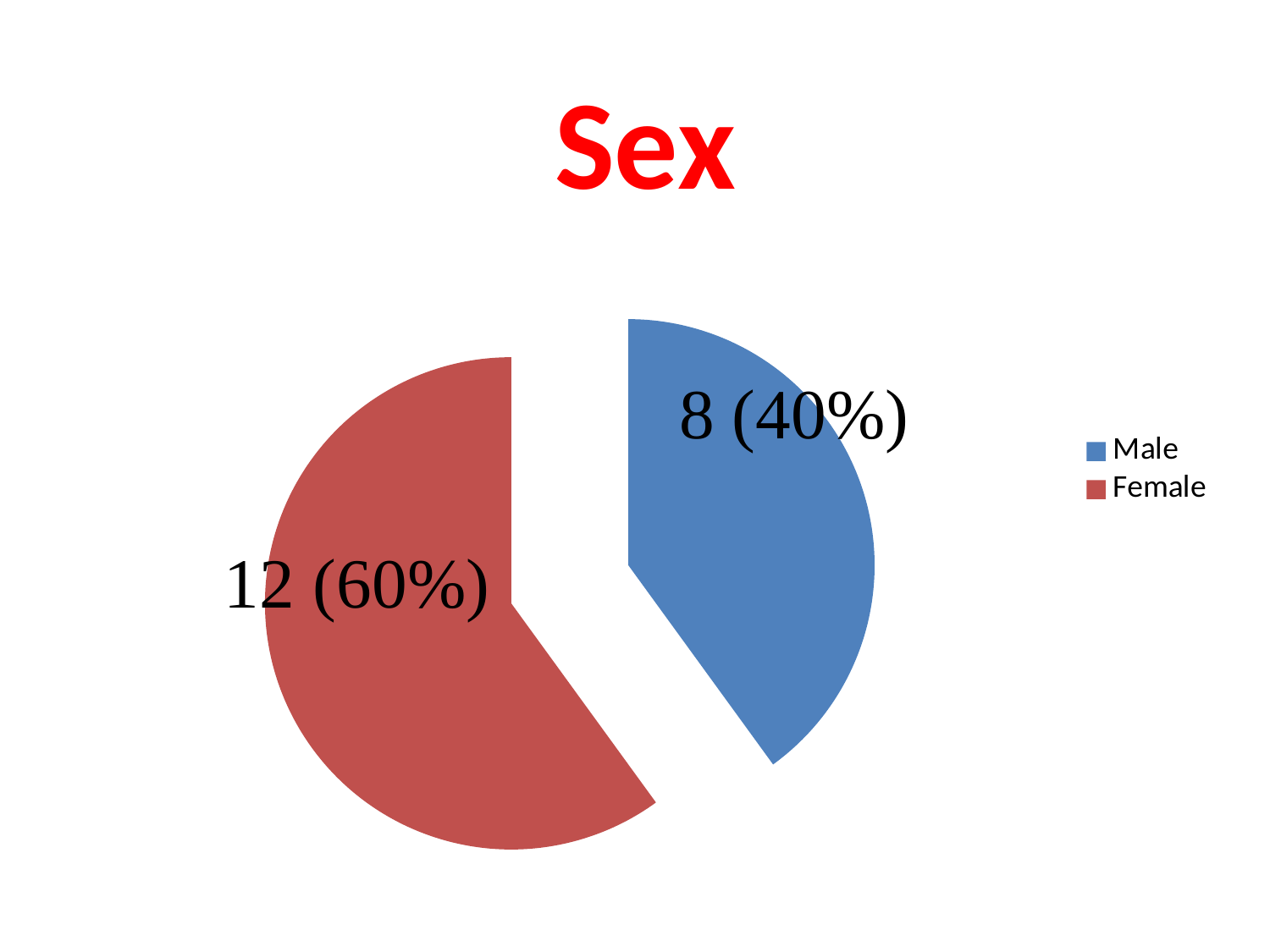
What share of the pie does the Male slice represent? 40% How many slices does the pie chart have? 2 What is the count shown for Female? 12 What share of the pie does the Female slice represent? 60% What is the count shown for Male? 8 How many entries does the legend list? 2 What kind of chart is shown on the slide? pie chart Which category has the largest slice? Female What is the difference between the Female count and the Male count? 4 Which colour represents Female in the chart? red Which category has the smallest slice? Male What is the title of the chart? Sex